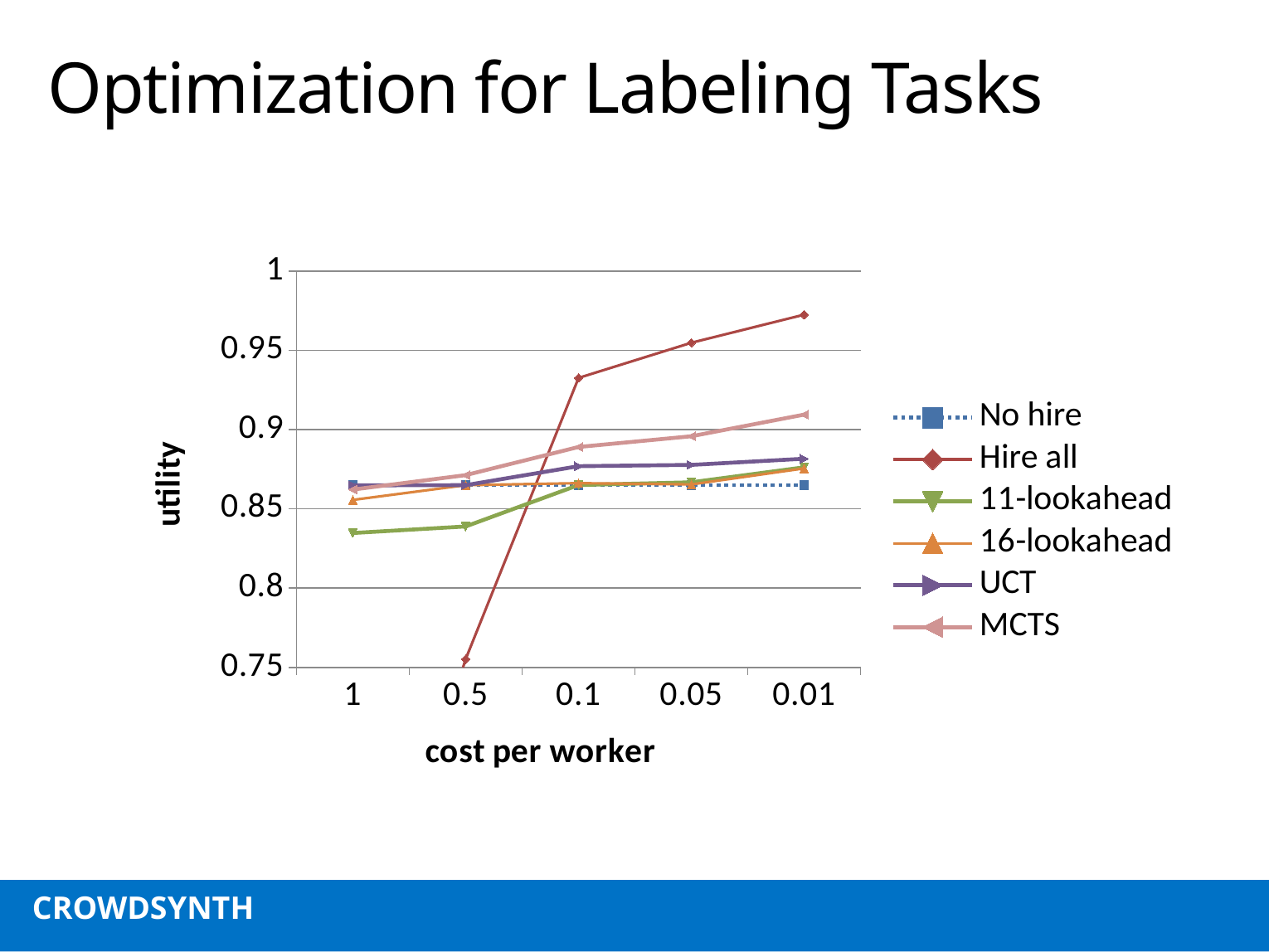
Is the utility for 11-lookahead at cost per worker 1 greater or less than 0.85? less Is the utility for Hire all at cost per worker 0.5 greater or less than 0.8? less Which series has the lowest utility at cost per worker 0.5? Hire all Which series has the highest utility at cost per worker 0.01? Hire all Does the utility for Hire all rise or fall moving from cost per worker 0.5 to 0.01? rise What is the title of the x axis? cost per worker Is the utility for Hire all at cost per worker 0.01 greater or less than 0.95? greater How many cost per worker values are plotted along the x axis? 5 How many series does the legend list? 6 What kind of chart is shown on the slide? line chart At cost per worker 0.01, which has the higher utility, MCTS or UCT? MCTS